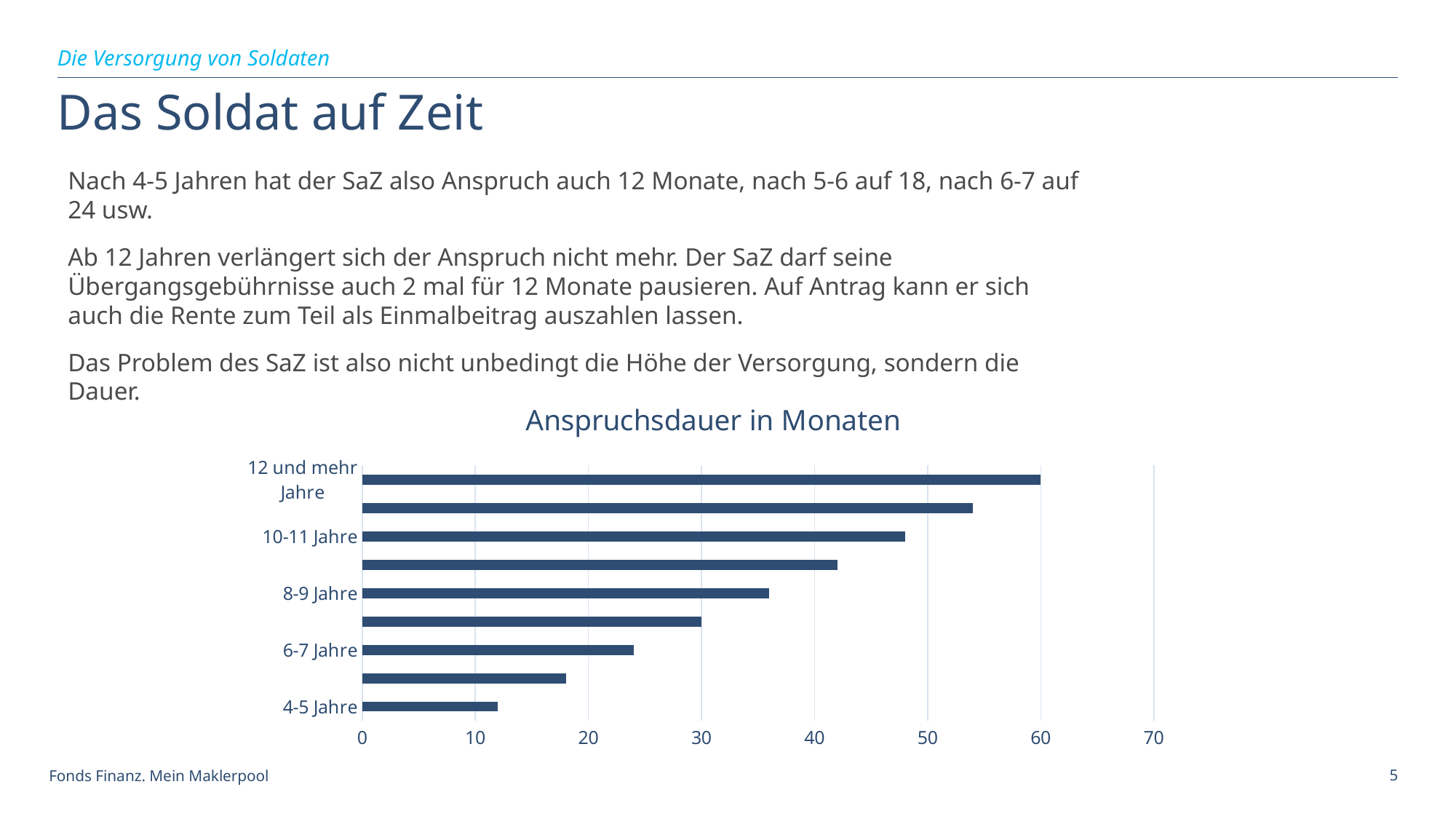
What is the value for "12 und mehr Jahre"? 60 Is the value for "8-9 Jahre" greater or less than 30? greater Is the value for "6-7 Jahre" greater or less than 30? less Which category has the lowest value? 4-5 Jahre Is the value for "4-5 Jahre" greater or less than 10? greater Do the values rise or fall as the years of service increase from "4-5 Jahre" to "12 und mehr Jahre"? rise What is the title of the chart? Anspruchsdauer in Monaten Which category has the highest value? 12 und mehr Jahre Which is larger, the value for "10-11 Jahre" or the value for "8-9 Jahre"? 10-11 Jahre How many bars are plotted in the chart? 9 What type of chart is shown on the slide? bar chart